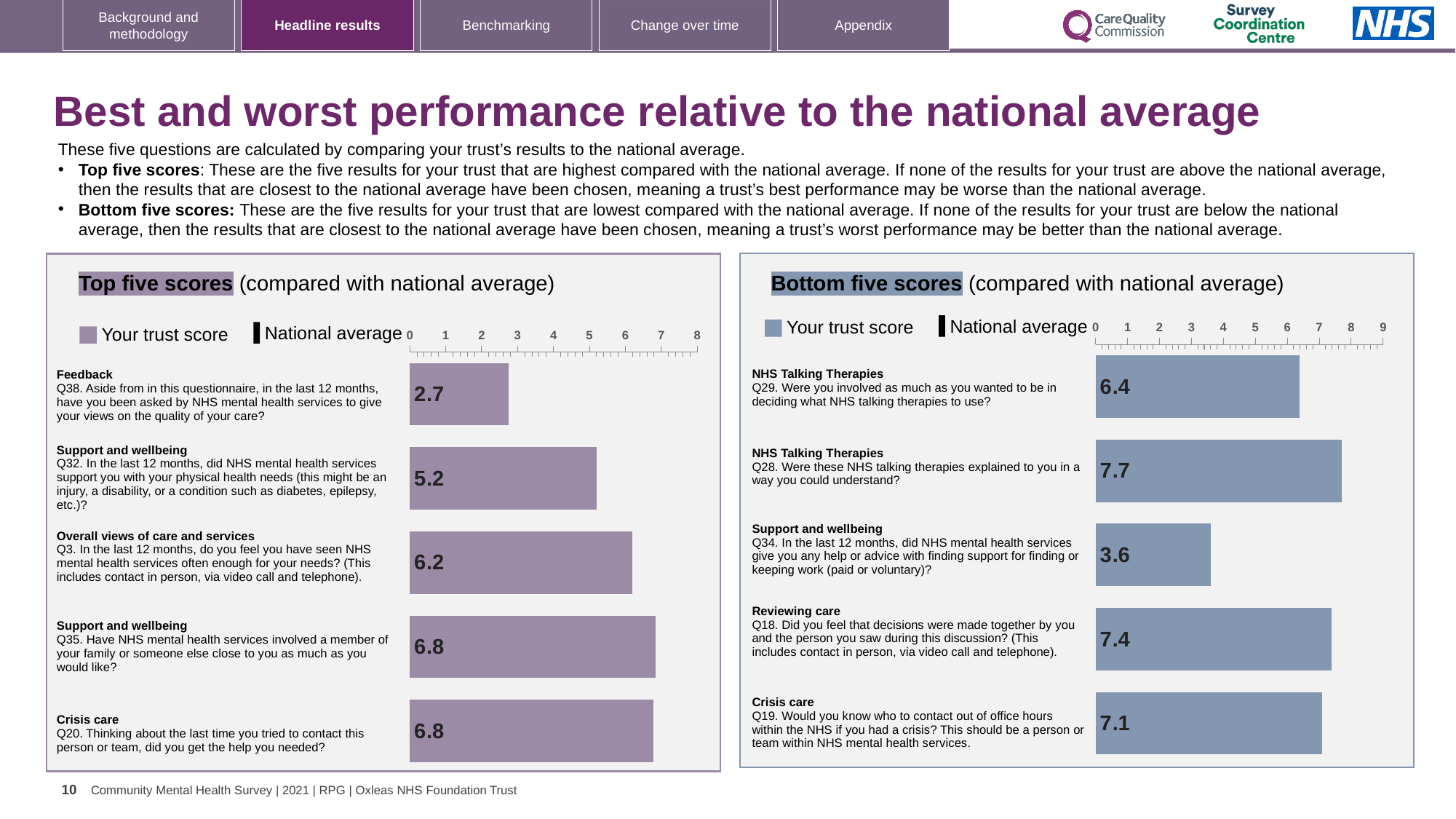
In the Top five scores chart, what is the difference between the trust scores for Q35 and Q32? 1.6 In the Top five scores chart, what is the trust score for Q38 (Feedback)? 2.7 In the Top five scores chart, which question has the lowest trust score? Q38 In the Bottom five scores chart, what is the difference between the trust scores for Q28 and Q34? 4.1 How many entries does the legend of the Bottom five scores chart list? 2 In the Top five scores chart, what is the trust score for Q3 (Overall views of care and services)? 6.2 In the Bottom five scores chart, what is the trust score for Q34 (Support and wellbeing)? 3.6 In the Bottom five scores chart, which is larger, the trust score for Q29 or for Q18? Q18 In the Top five scores chart, how many bars are plotted? 5 In the Bottom five scores chart, which question has the highest trust score? Q28 What type of chart is the Top five scores chart? Bar chart In the Bottom five scores chart, what is the trust score for Q19 (Crisis care)? 7.1